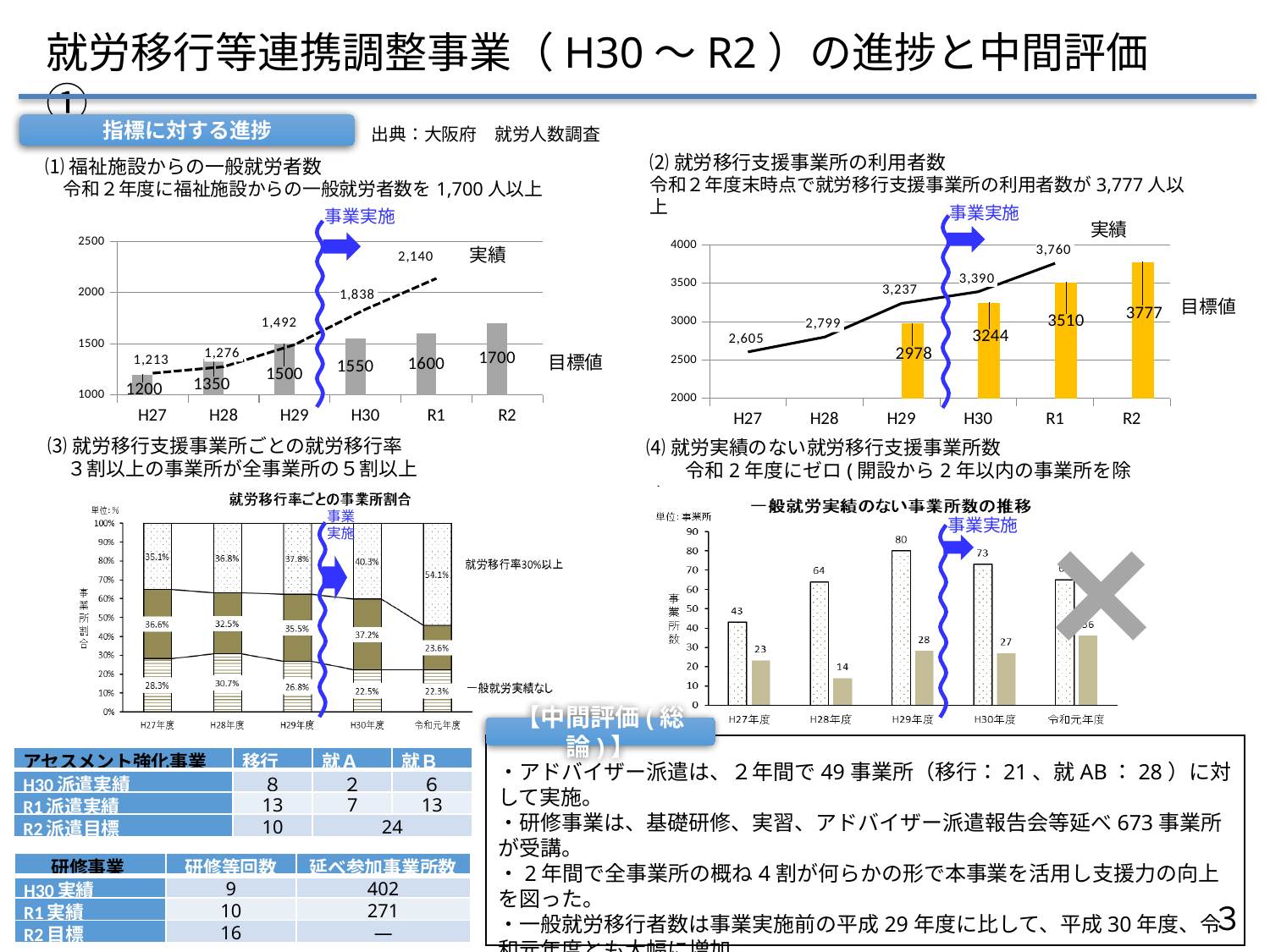
What kind of chart is 一般就労実績のない事業所数の推移 (bottom right)? bar chart In the chart for (1) 福祉施設からの一般就労者数 (top left), what is the 目標値 for R2? 1700 In the chart titled 就労移行率ごとの事業所割合 (bottom left), which year has the highest 就労移行率30%以上 share? 令和元年度 In the chart titled 一般就労実績のない事業所数の推移 (bottom right), what is the value of the taller bar for H29年度? 80 In the chart for (1) 福祉施設からの一般就労者数 (top left), does the 実績 line rise or fall from H27 to R1? rise In the chart for (1) 福祉施設からの一般就労者数 (top left), what is the difference between the 実績 values for H30 and H29? 346 In the chart titled 就労移行率ごとの事業所割合 (bottom left), what is the 就労移行率30%以上 share for 令和元年度? 54.1% In the chart for (2) 就労移行支援事業所の利用者数 (top right), what is the 目標値 for R2? 3777 In the chart for (1) 福祉施設からの一般就労者数 (top left), what is the 実績 value for R1? 2,140 In the chart for (2) 就労移行支援事業所の利用者数 (top right), which is larger for R1: the 実績 value or the 目標値? 実績 In the chart for (2) 就労移行支援事業所の利用者数 (top right), how many 目標値 bars are shown? 4 In the chart for (2) 就労移行支援事業所の利用者数 (top right), what is the 実績 value for H29? 3,237